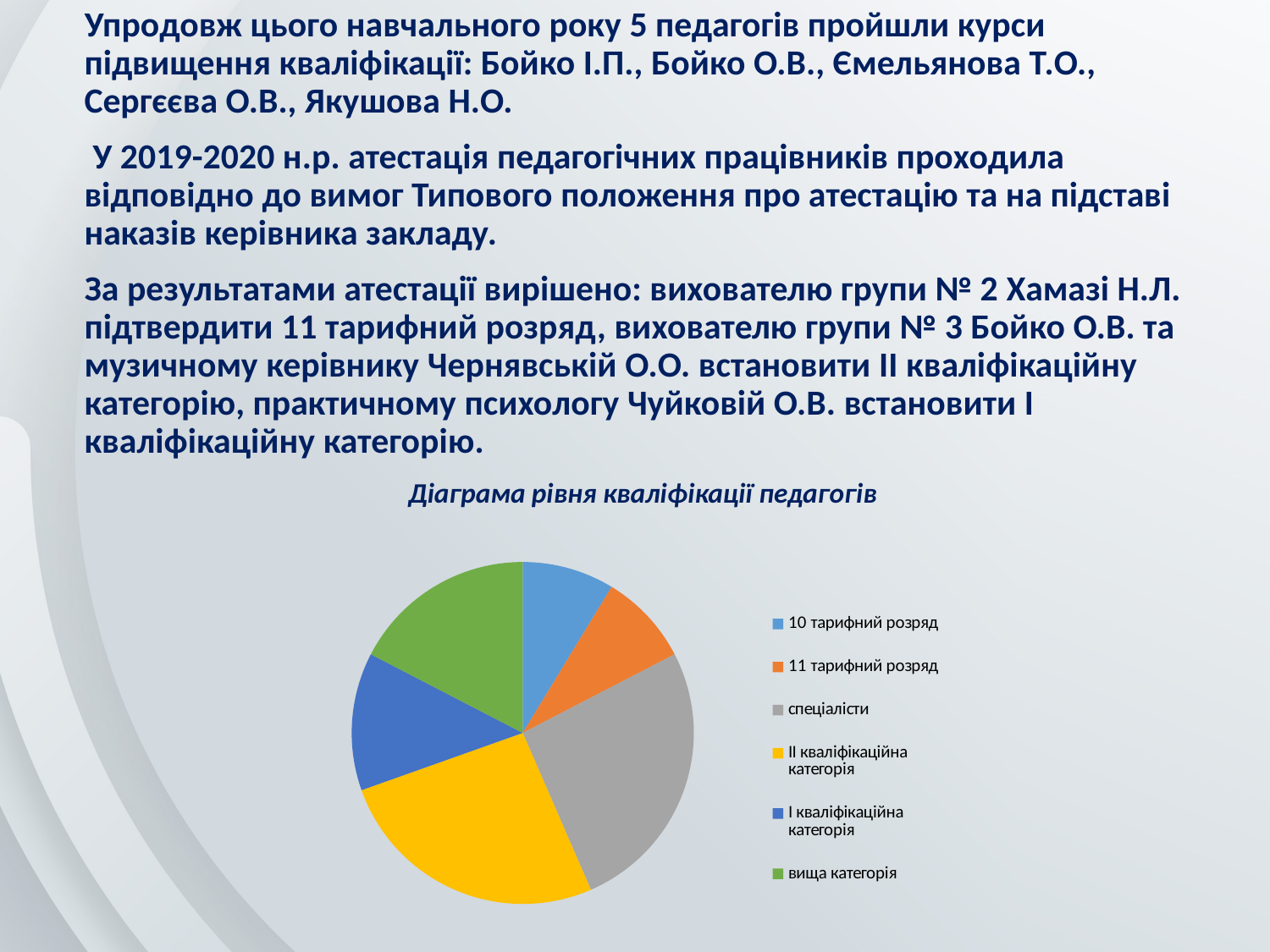
Which slice is larger: спеціалісти or 10 тарифний розряд? спеціалісти What kind of chart is shown on the slide? pie chart Which slice is larger: вища категорія or 10 тарифний розряд? вища категорія What colour is the слice for спеціалісти? gray How many categories does the pie chart have? 6 Which slice is larger: II кваліфікаційна категорія or 11 тарифний розряд? II кваліфікаційна категорія What is the title of the chart? Діаграма рівня кваліфікації педагогів How many entries does the legend list? 6